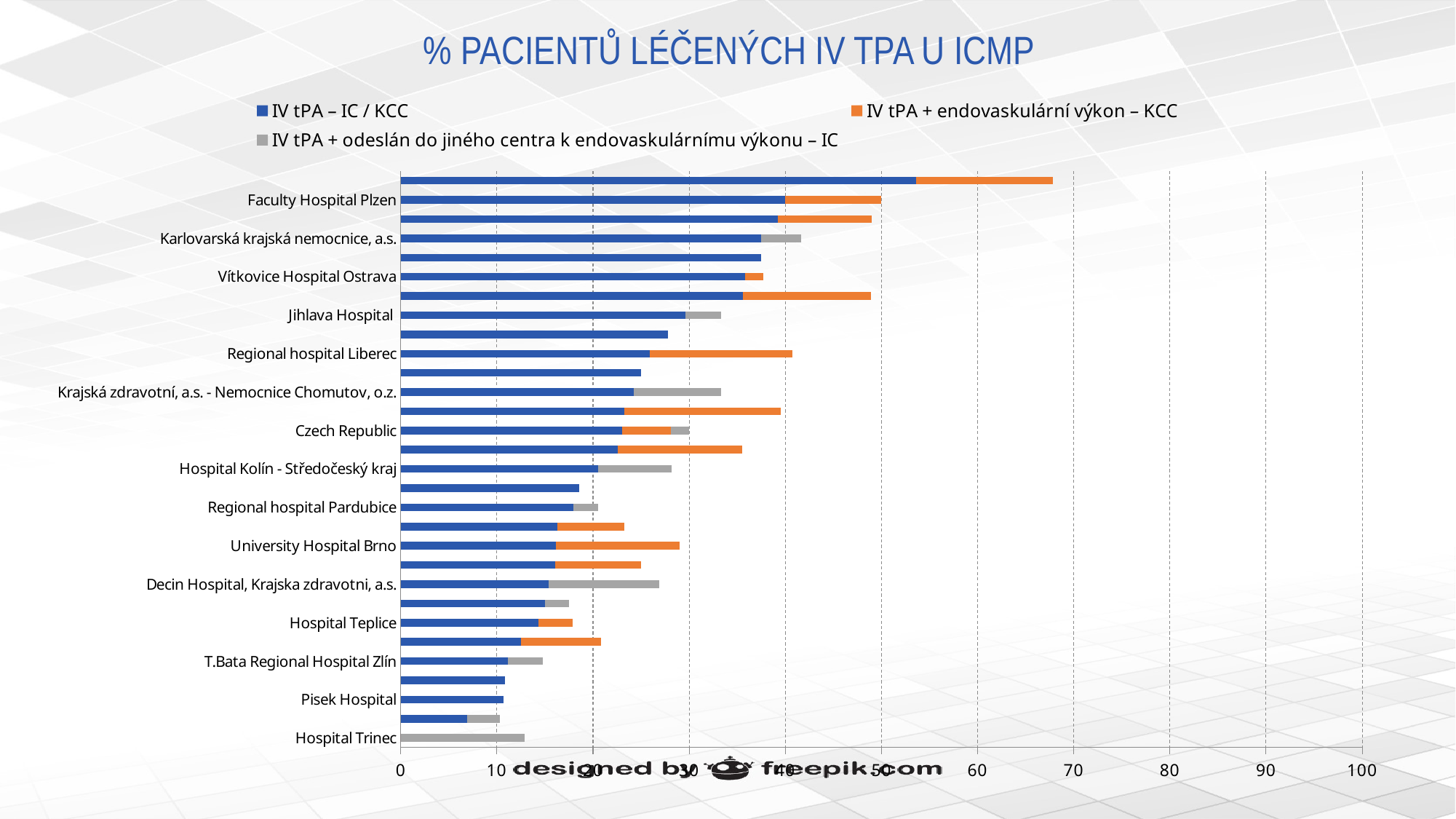
How many series does the legend list? 3 Is the "IV tPA – IC / KCC" value for Czech Republic greater or less than 20? greater Is the total length of the stacked bar for Hospital Trinec greater or less than 20? less Which colour represents the series "IV tPA + endovaskulární výkon – KCC"? Orange What kind of chart is shown on the slide? Bar chart What is the title of the chart? % PACIENTŮ LÉČENÝCH IV TPA U ICMP Which has the longer total stacked bar, Regional hospital Liberec or Hospital Teplice? Regional hospital Liberec Which has the larger "IV tPA – IC / KCC" value, Faculty Hospital Plzen or Pisek Hospital? Faculty Hospital Plzen Is the "IV tPA – IC / KCC" value for Faculty Hospital Plzen greater or less than 30? greater